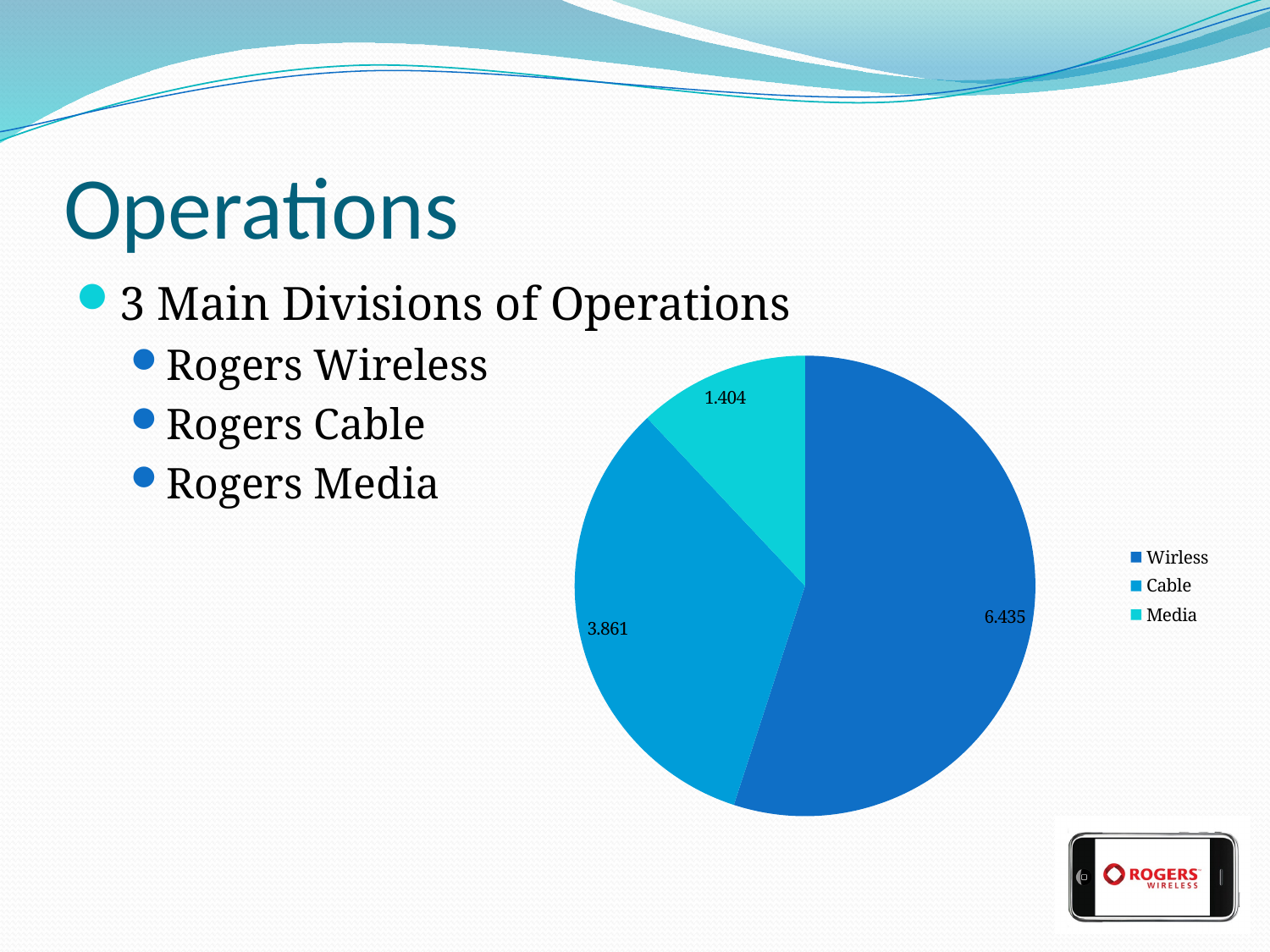
What is the difference between the Wirless and Cable values in the pie chart? 2.574 Which is larger in the pie chart, Cable or Media? Cable Which slice of the pie chart has the smallest value? Media What is the total of all slices in the pie chart? 11.700 What is the value of the Cable slice in the pie chart? 3.861 What is the value of the Wirless slice in the pie chart? 6.435 What type of chart is shown on the slide? Pie chart How many slices does the pie chart have? 3 What are the three entries listed in the pie chart's legend? Wirless, Cable, Media What is the difference between the Cable and Media values in the pie chart? 2.457 Which slice of the pie chart has the largest value? Wirless What is the value of the Media slice in the pie chart? 1.404